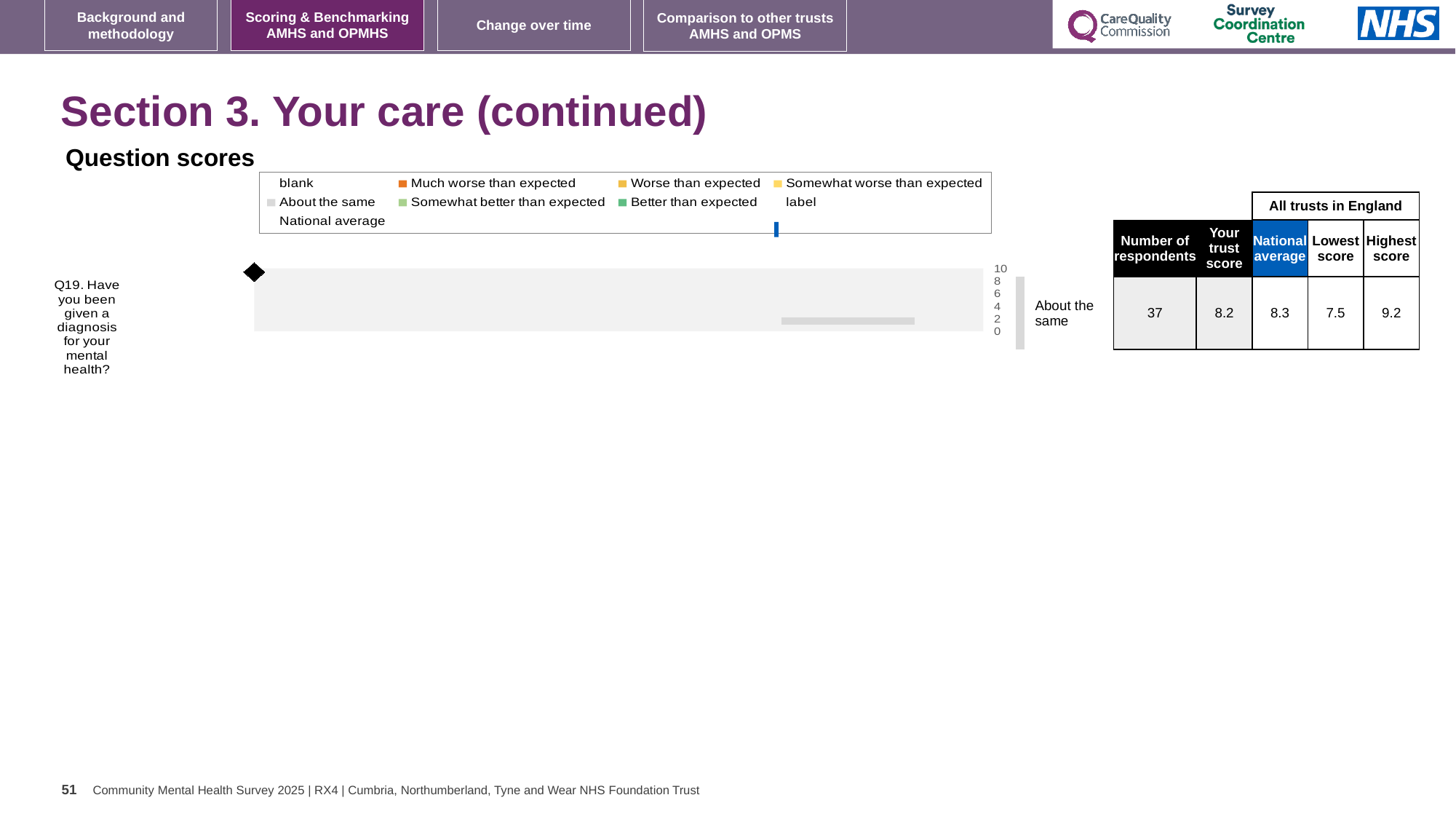
What kind of chart is shown under 'Question scores'? bar chart What is the full text of the question plotted in the Question scores chart? Q19. Have you been given a diagnosis for your mental health? In the table beside the Question scores chart, how many respondents answered Q19? 37 In the table beside the Question scores chart, what is the National average for Q19? 8.3 In the Question scores chart legend, what colour marks 'Much worse than expected'? orange How many survey questions are plotted in the Question scores chart? 1 For Q19, which is larger: the trust score or the National average? National average In the table beside the Question scores chart, what is the Highest score for Q19? 9.2 Which benchmark category is shown next to the bar for Q19 in the Question scores chart? About the same In the table beside the Question scores chart, what is the 'Your trust score' value for Q19? 8.2 In the table beside the Question scores chart, what is the Lowest score for Q19? 7.5 For Q19, what is the difference between the Highest score and the Lowest score in the table? 1.7